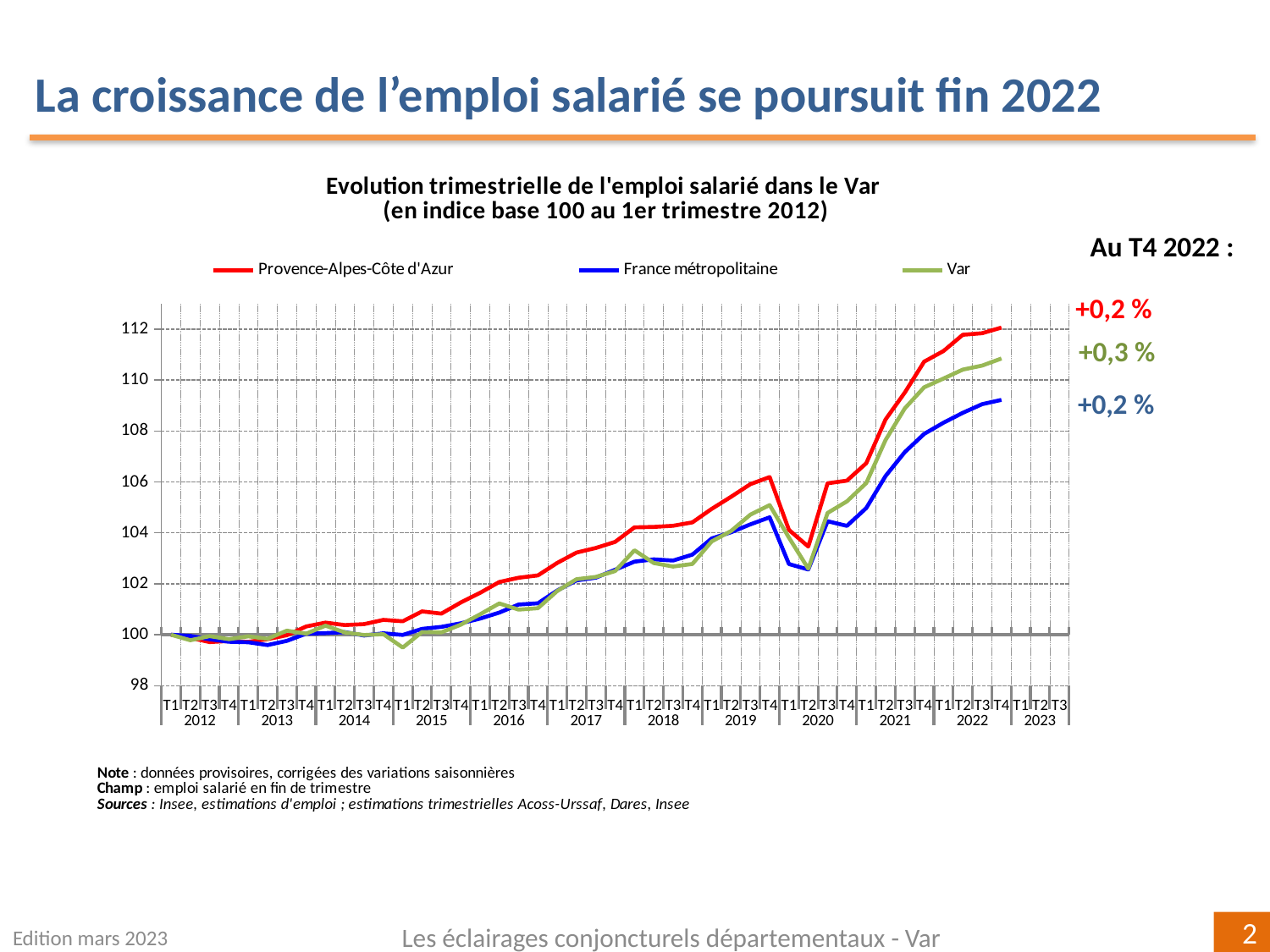
According to the annotation on the slide, what is the change for Var at T4 2022? +0,3 % Which series has the lowest index value at T4 2022? France métropolitaine Which colour is used for the Var series in the chart? green What kind of chart is shown on the slide? line chart What is the title of the chart? Evolution trimestrielle de l'emploi salarié dans le Var (en indice base 100 au 1er trimestre 2012) Is the value for Provence-Alpes-Côte d'Azur at T4 2022 greater or less than 110? greater How many series does the legend of the chart list? 3 Which series has the highest index value at T4 2022? Provence-Alpes-Côte d'Azur What is the index value of all three series at T1 2012? 100 Overall, do the index values rise or fall from 2012 to 2022? rise Is the value for France métropolitaine at T4 2022 greater or less than 110? less According to the annotation on the slide, what is the change for Provence-Alpes-Côte d'Azur at T4 2022? +0,2 %